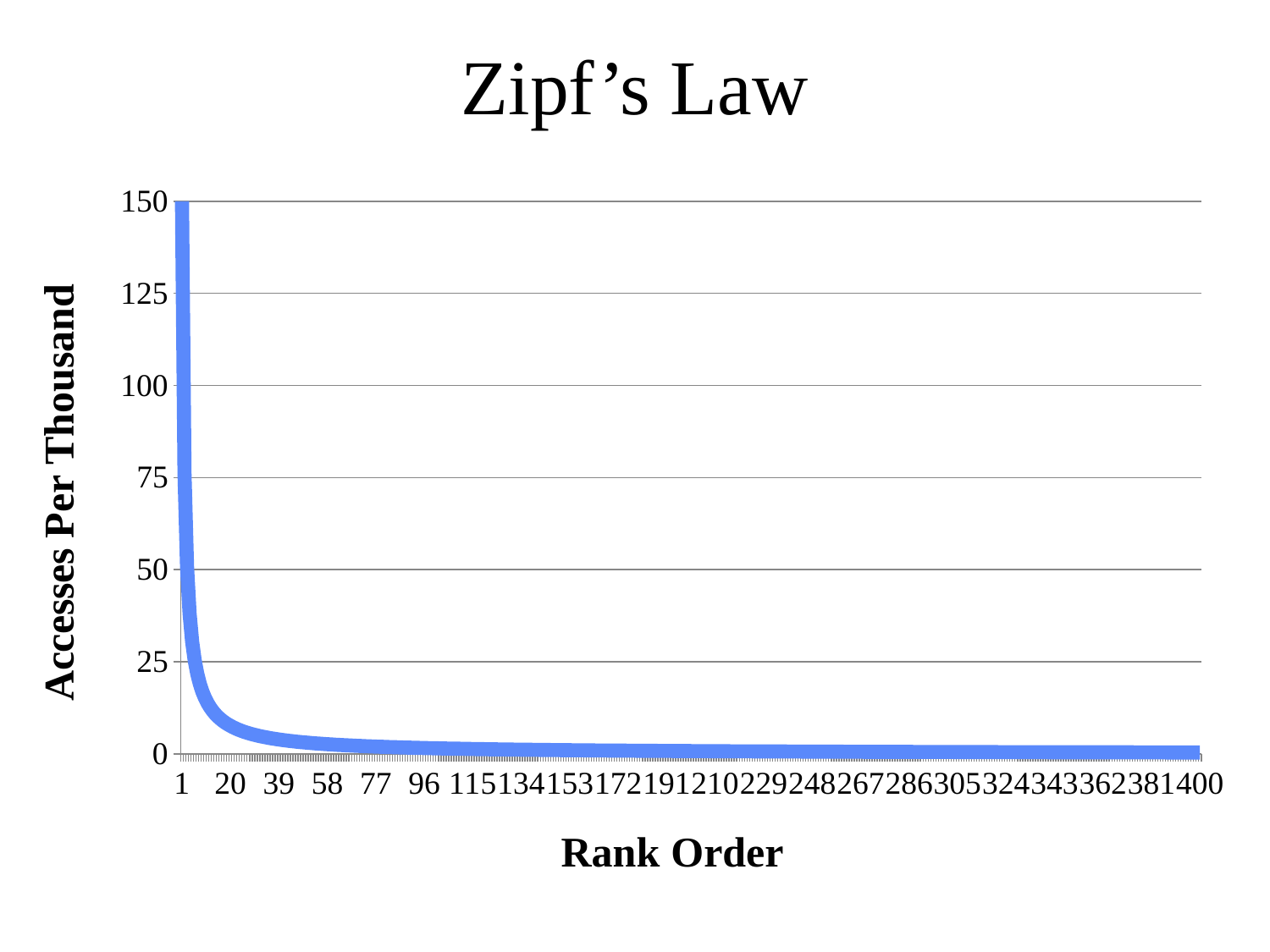
What is the label of the y axis? Accesses Per Thousand What kind of chart is shown on the slide? line chart Do the values rise or fall as rank order increases along the x axis? fall Which has the larger value, rank order 1 or rank order 400? rank order 1 What is the highest value shown on the y axis? 150 Is the value at rank order 1 greater or less than 125? greater At which rank order is the value highest? 1 Is the value at rank order 400 greater or less than 25? less Is the value at rank order 20 greater or less than 25? less What is the title of the chart? Zipf's Law